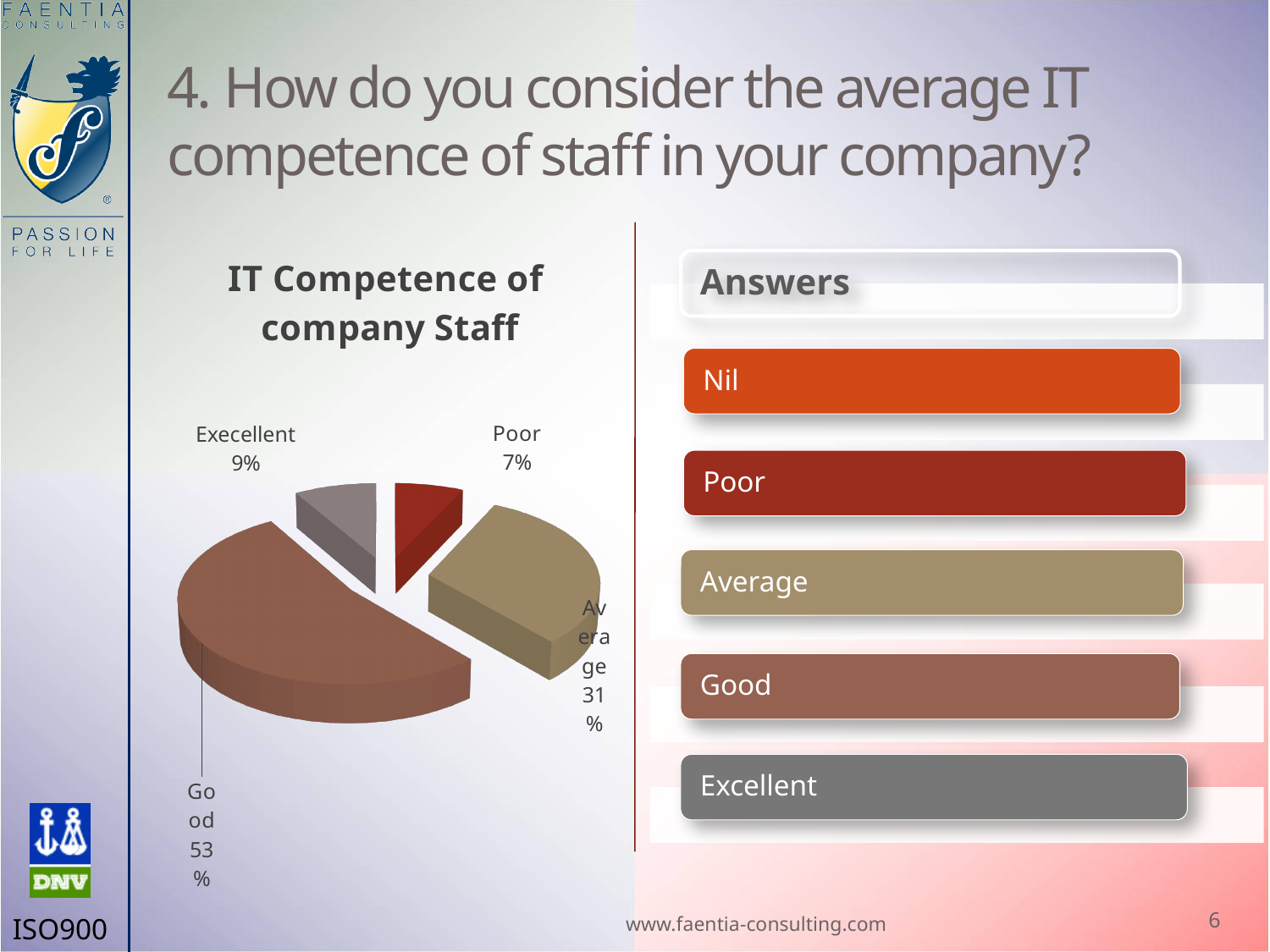
What kind of chart is shown on the slide? pie chart What share of the pie does the Good slice represent? 53% What percentage is shown for the Average slice? 31% What is the difference in percentage points between the Good and Average slices? 22 How many slices are labelled in the pie chart? 4 What is the combined percentage of the Good and Average slices? 84% What percentage is shown for the Excellent slice? 9% What is the title of the pie chart? IT Competence of company Staff What percentage is shown for the Poor slice? 7% Which category has the largest slice of the pie? Good Which slice is larger, Excellent or Poor? Excellent Which category has the smallest slice of the pie? Poor